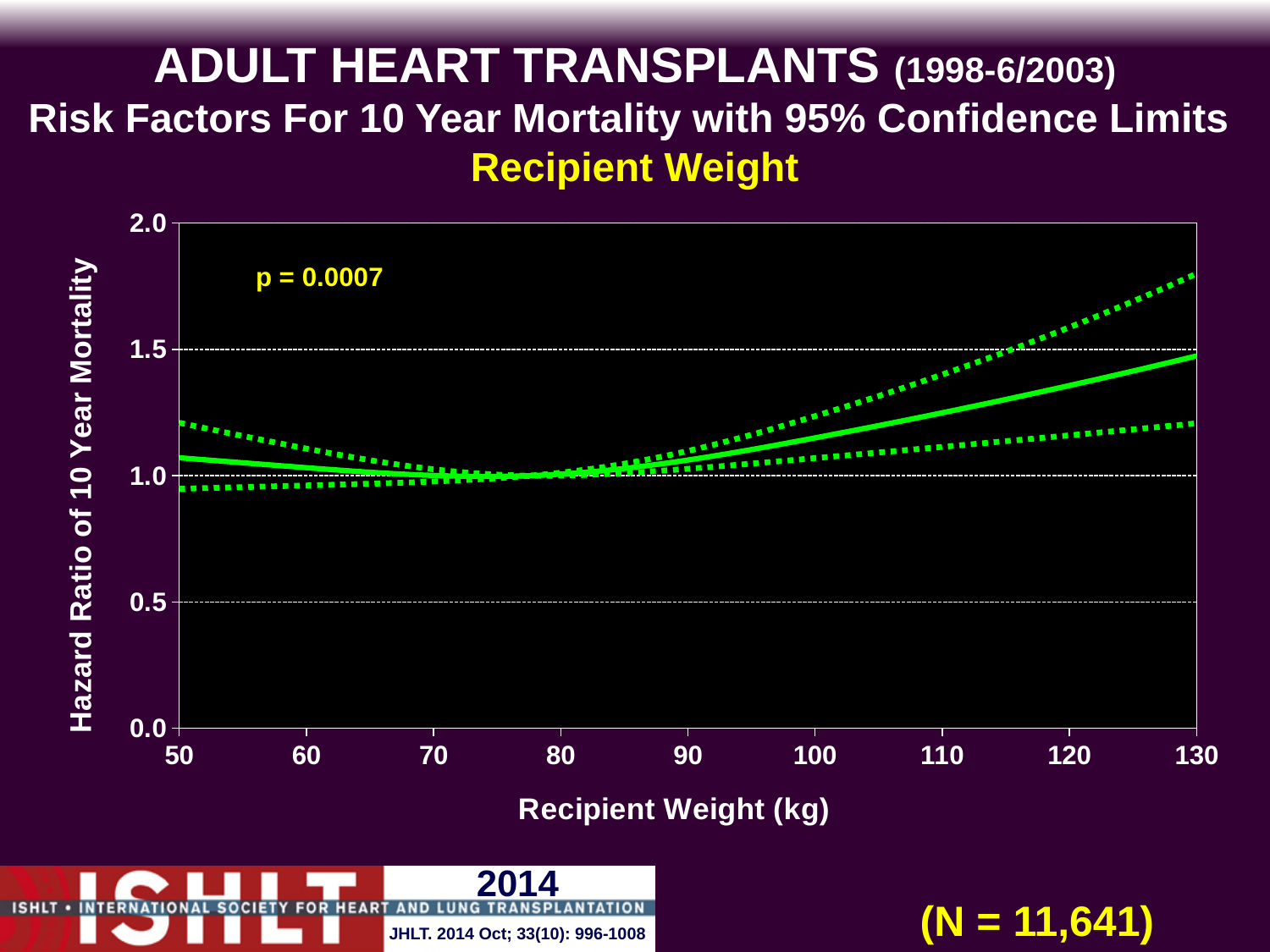
Is the hazard ratio (solid line) higher at a recipient weight of 130 kg or at 80 kg? 130 kg What is the p-value printed on the chart? p = 0.0007 Is the upper 95% confidence limit at a recipient weight of 130 kg greater or less than 1.5? greater What kind of chart is shown on the slide? line chart How many lines are plotted on the chart? 3 Does the hazard ratio (solid line) rise or fall as recipient weight increases from 80 kg to 130 kg? rise Is the hazard ratio (solid line) at a recipient weight of 70 kg greater or less than 1.5? less Is the hazard ratio (solid line) at a recipient weight of 50 kg greater or less than 1.5? less What is the sample size (N) shown on the slide? 11,641 How many tick labels are shown on the x axis (Recipient Weight)? 9